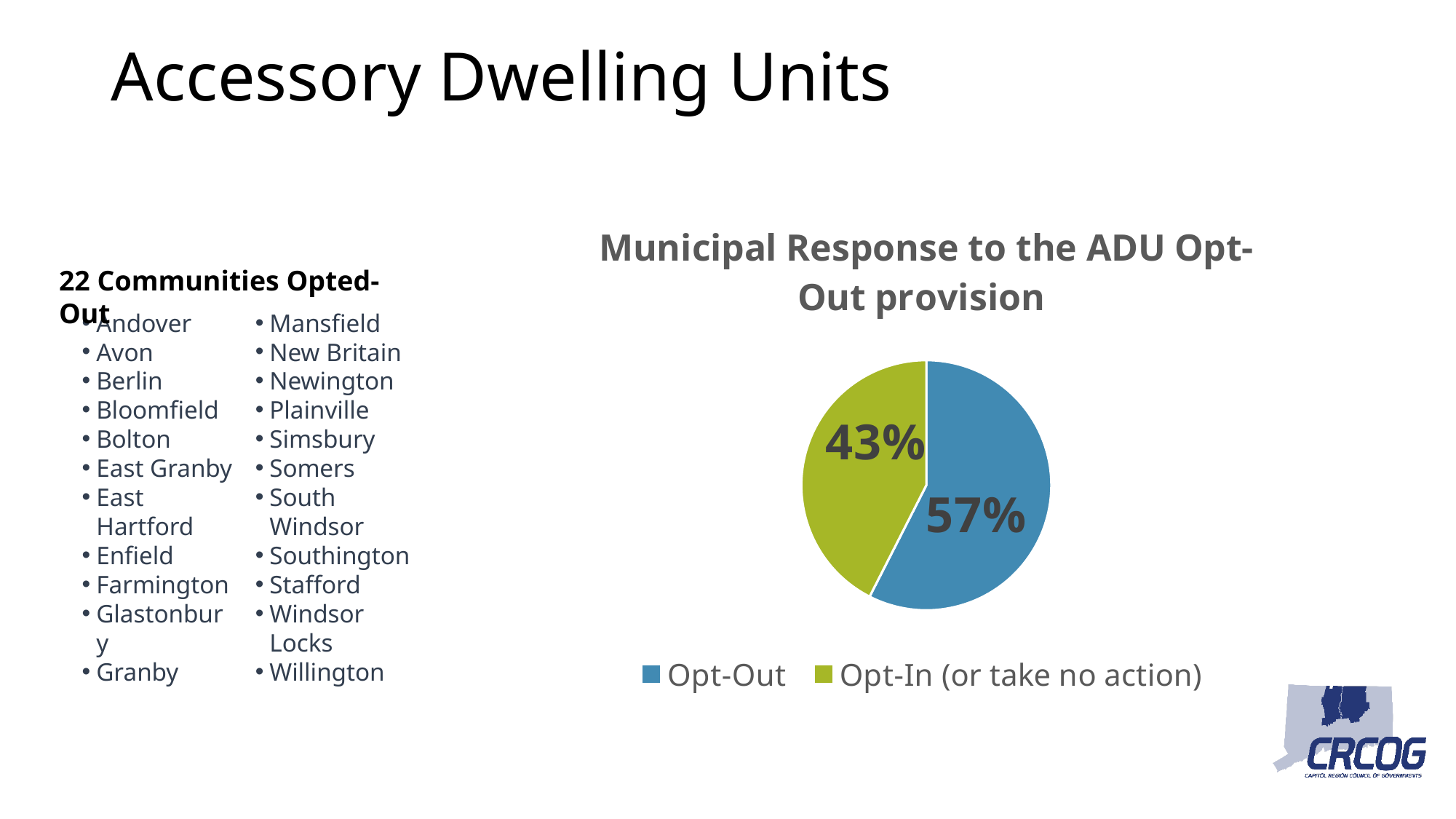
What is the title of the chart? Municipal Response to the ADU Opt-Out provision What kind of chart is shown on the slide? Pie chart How many slices does the pie chart have? 2 Is the Opt-Out share larger or smaller than the Opt-In (or take no action) share? Larger Which response has the smaller share of the pie? Opt-In (or take no action) Which response has the larger share of the pie? Opt-Out How many entries does the legend list? 2 Is the Opt-Out share greater or less than 50%? greater What colour is the Opt-Out slice? Blue What is the difference in percentage points between the Opt-Out and Opt-In (or take no action) shares? 14 What percentage of municipalities chose Opt-Out? 57% What percentage of municipalities chose Opt-In (or take no action)? 43%